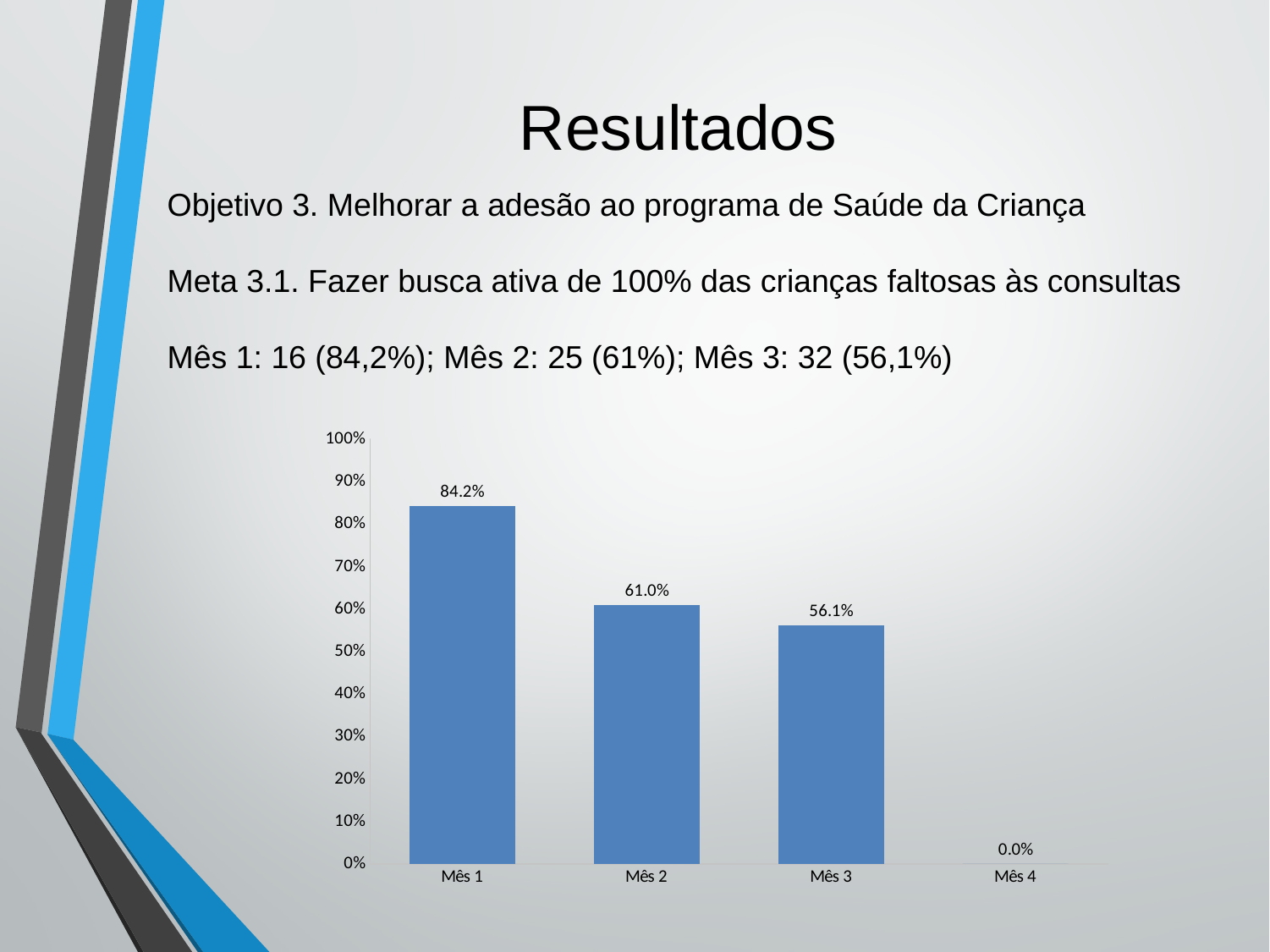
What is the difference between the values for Mês 1 and Mês 2? 23.2% What is the value for Mês 3? 56.1% What is the value for Mês 1? 84.2% What is the value for Mês 2? 61.0% What is the value for Mês 4? 0.0% What kind of chart is shown on the slide? bar chart How many categories are shown on the x axis? 4 Which is larger, the value for Mês 2 or the value for Mês 3? Mês 2 Which category has the lowest value? Mês 4 Which category has the highest value? Mês 1 Is the value for Mês 1 greater or less than 80%? greater What is the difference between the values for Mês 2 and Mês 3? 4.9%